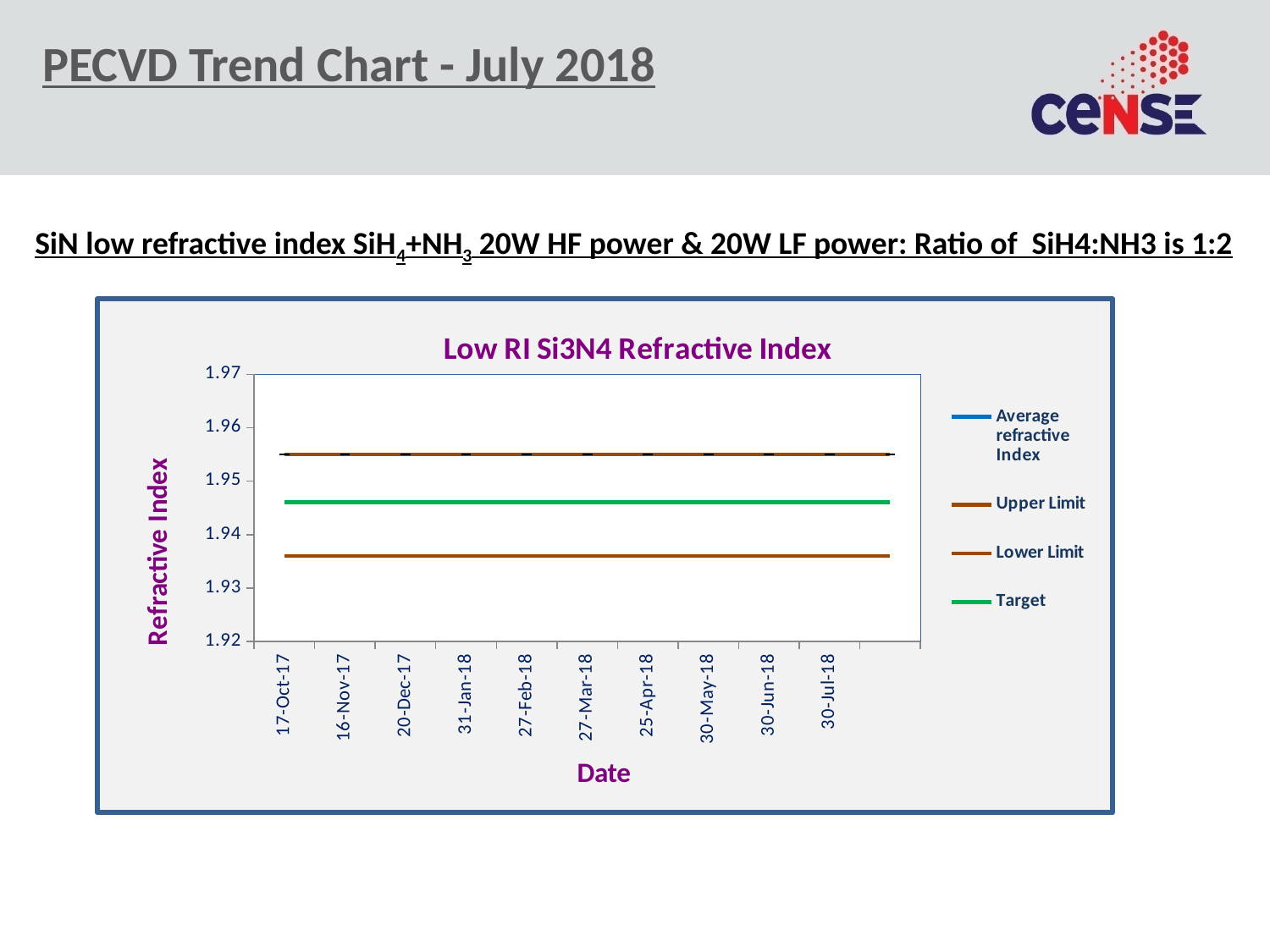
Is the value of the Lower Limit line greater or less than 1.94? less Is the value of the Upper Limit line greater or less than 1.95? greater How many date labels are shown on the x axis of the chart? 10 Does the Target line rise, fall, or stay flat across the dates on the x axis? stays flat What kind of chart is shown on the slide? line chart Which line is higher on the chart, Upper Limit or Lower Limit? Upper Limit How many series does the chart legend list? 4 What is the label of the y axis? Refractive Index Which line is higher on the chart, Target or Lower Limit? Target What is the title of the chart? Low RI Si3N4 Refractive Index Is the value of the Target line greater or less than 1.95? less